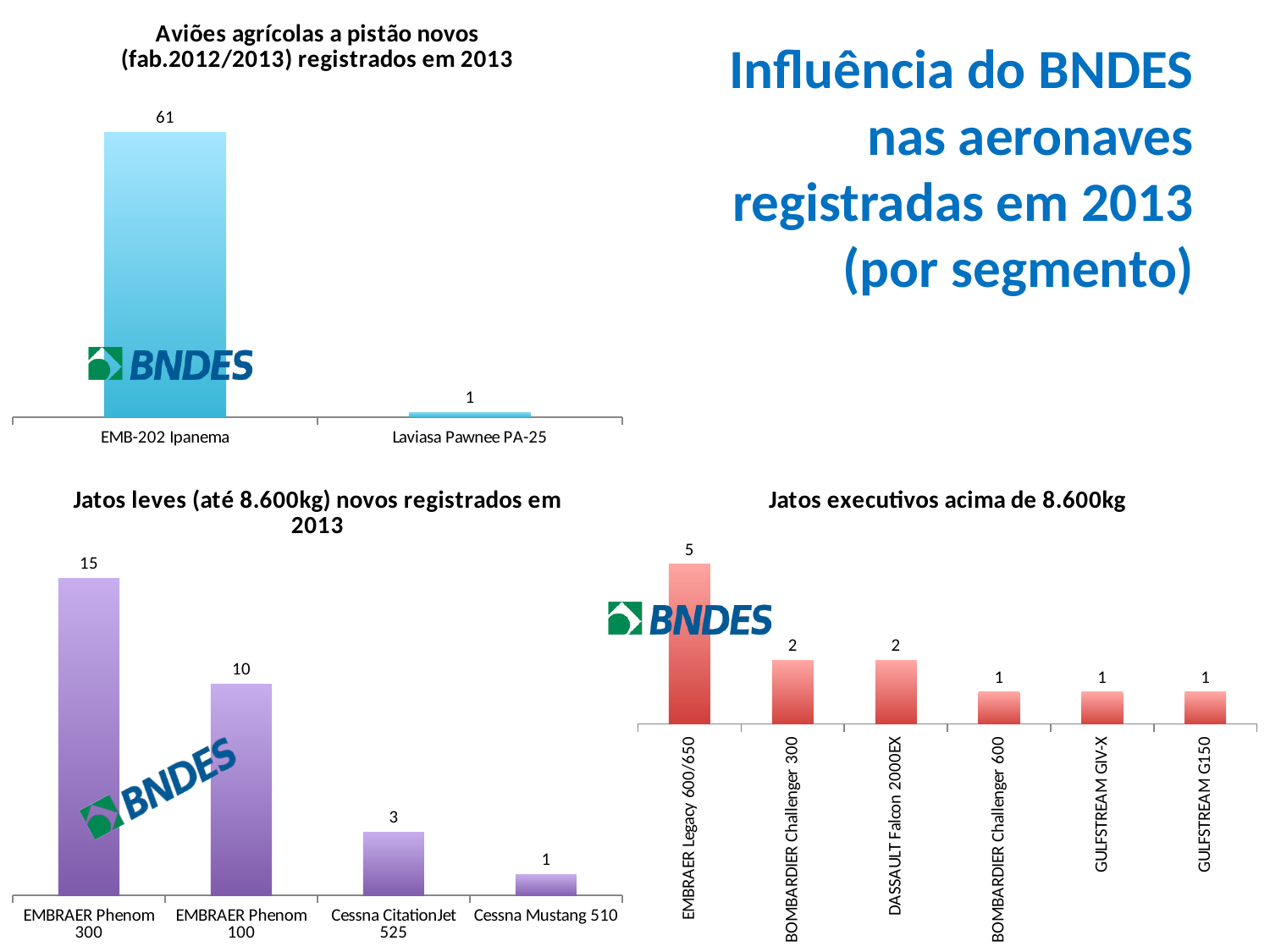
In the chart titled "Jatos executivos acima de 8.600kg", how many categories are shown? 6 In the chart titled "Jatos executivos acima de 8.600kg", what is the value for EMBRAER Legacy 600/650? 5 In the chart titled "Aviões agrícolas a pistão novos (fab.2012/2013) registrados em 2013", what is the value for EMB-202 Ipanema? 61 What kind of chart is the chart titled "Jatos executivos acima de 8.600kg"? bar chart In the chart titled "Jatos leves (até 8.600kg) novos registrados em 2013", do the values rise or fall from left to right? fall In the chart titled "Jatos leves (até 8.600kg) novos registrados em 2013", which category has the highest value? EMBRAER Phenom 300 In the chart titled "Jatos leves (até 8.600kg) novos registrados em 2013", what is the value for EMBRAER Phenom 100? 10 In the chart titled "Jatos leves (até 8.600kg) novos registrados em 2013", what is the difference between EMBRAER Phenom 300 and Cessna CitationJet 525? 12 In the chart titled "Jatos leves (até 8.600kg) novos registrados em 2013", which category has the lowest value? Cessna Mustang 510 In the chart titled "Jatos executivos acima de 8.600kg", which is larger, BOMBARDIER Challenger 300 or GULFSTREAM G150? BOMBARDIER Challenger 300 In the chart titled "Aviões agrícolas a pistão novos (fab.2012/2013) registrados em 2013", what is the difference between EMB-202 Ipanema and Laviasa Pawnee PA-25? 60 In the chart titled "Aviões agrícolas a pistão novos (fab.2012/2013) registrados em 2013", how many categories are shown? 2